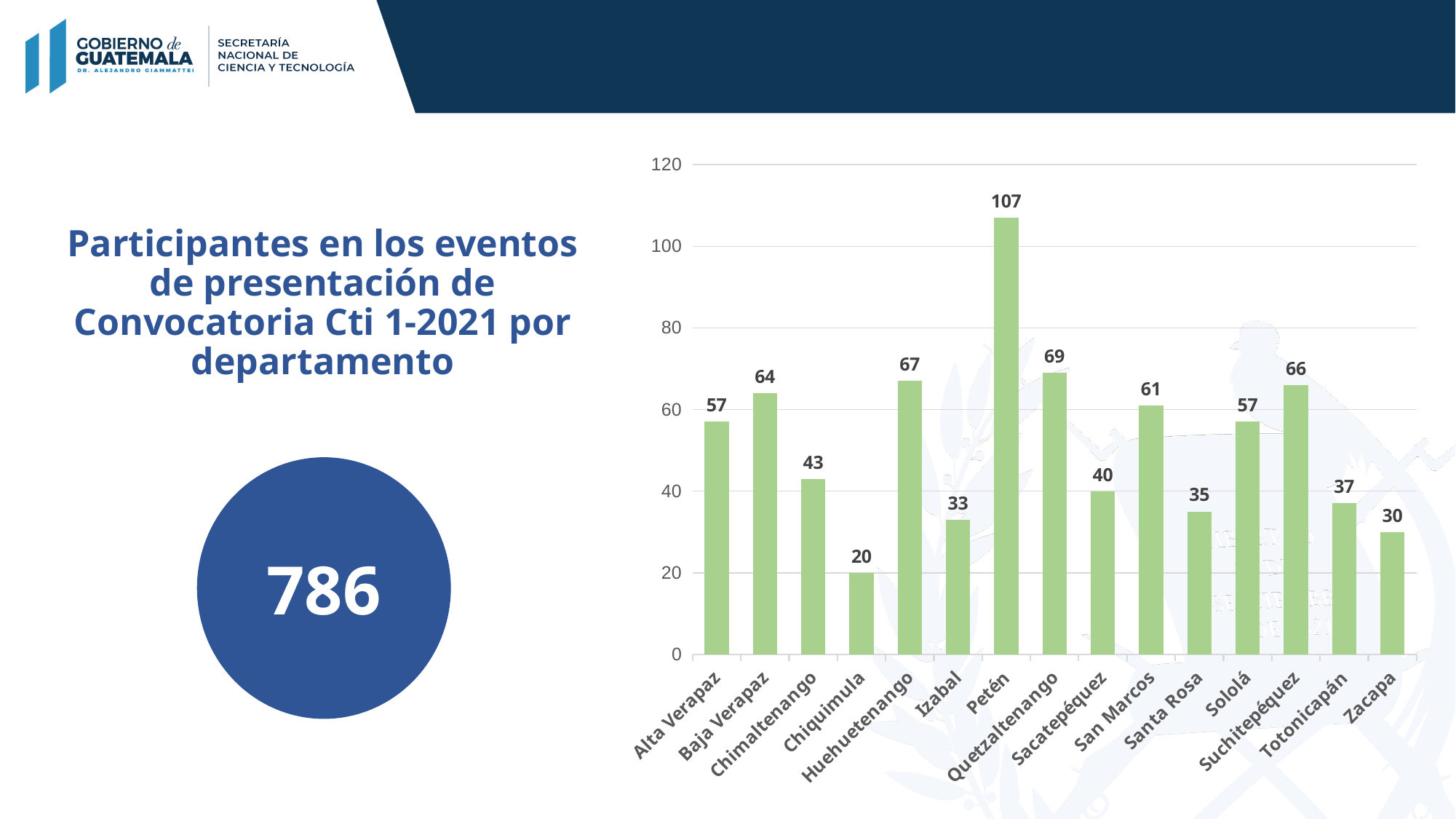
What is the difference between the values for Petén and Quetzaltenango? 38 Is the value for Suchitepéquez greater or less than 60? greater What kind of chart is shown on the slide? bar chart Which department has the highest number of participants? Petén What is the difference between the values for Alta Verapaz and Zacapa? 27 What is the value for Huehuetenango? 67 How many participants are shown for Petén? 107 What total number is shown in the blue circle on the left of the slide? 786 Which department has the lowest number of participants? Chiquimula What is the value for Chiquimula? 20 How many departments are shown on the x axis? 15 Which has a larger value, Baja Verapaz or San Marcos? Baja Verapaz